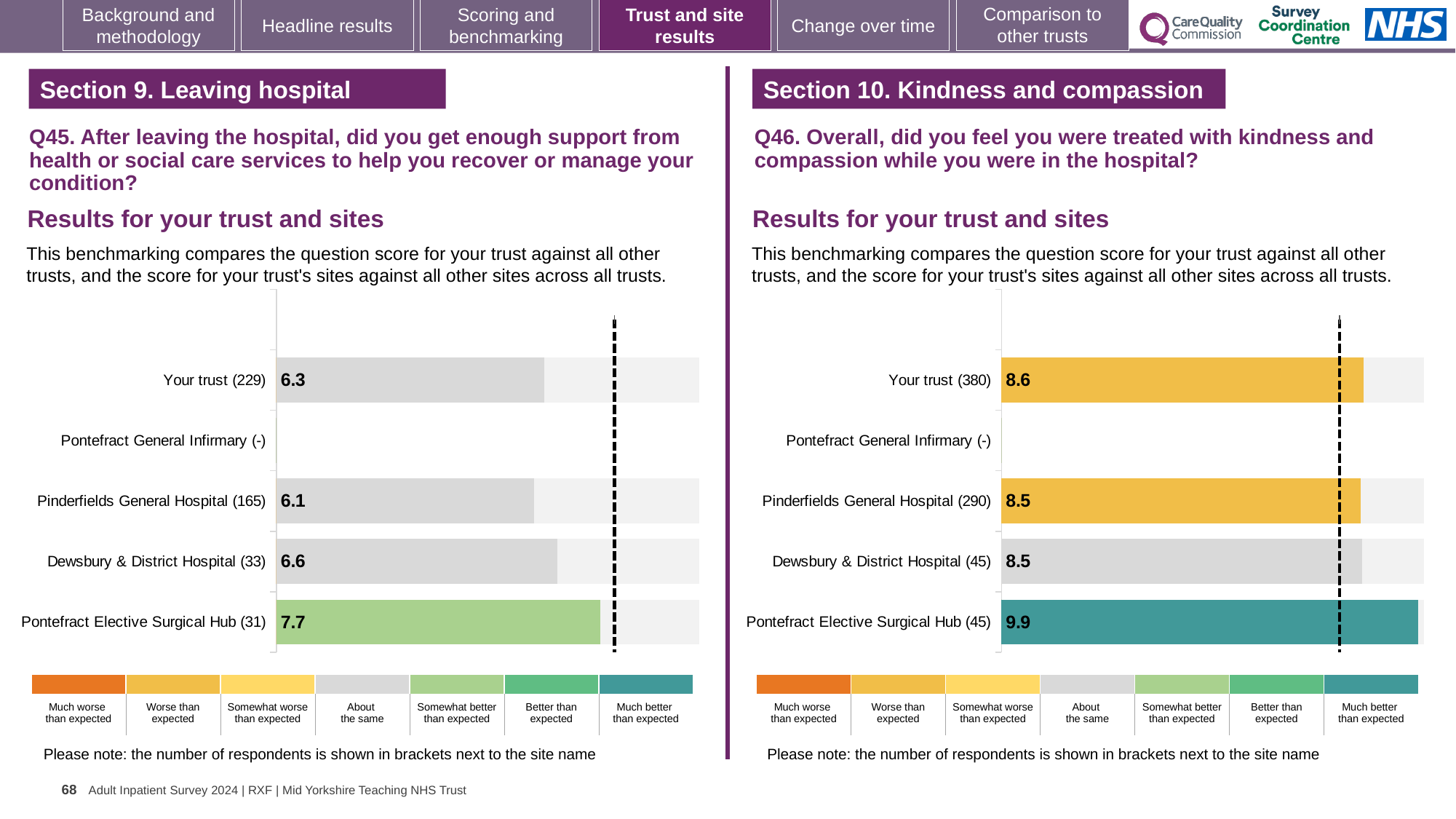
In the Q45 chart on the left, what is the difference between the scores for Pontefract Elective Surgical Hub and Dewsbury & District Hospital? 1.1 In the Q45 chart on the left, what is the score for Your trust? 6.3 In the Q45 chart on the left, which has the higher score, Your trust or Dewsbury & District Hospital? Dewsbury & District Hospital How many trust or site rows are listed in the Q46 chart on the right? 5 In the Q46 chart on the right, how many respondents are shown in brackets for Pinderfields General Hospital? 290 In the Q46 chart on the right, what is the difference between the scores for Pontefract Elective Surgical Hub and Your trust? 1.3 In the Q45 chart on the left, which site has the lowest score? Pinderfields General Hospital In the Q46 chart on the right, which site has the highest score? Pontefract Elective Surgical Hub In the Q46 chart on the right, what is the score for Your trust? 8.6 In the Q46 chart on the right, what is the score for Pinderfields General Hospital? 8.5 In the Q45 chart on the left, what is the score for Pontefract Elective Surgical Hub? 7.7 What kind of chart is the Q45 chart on the left? Bar chart